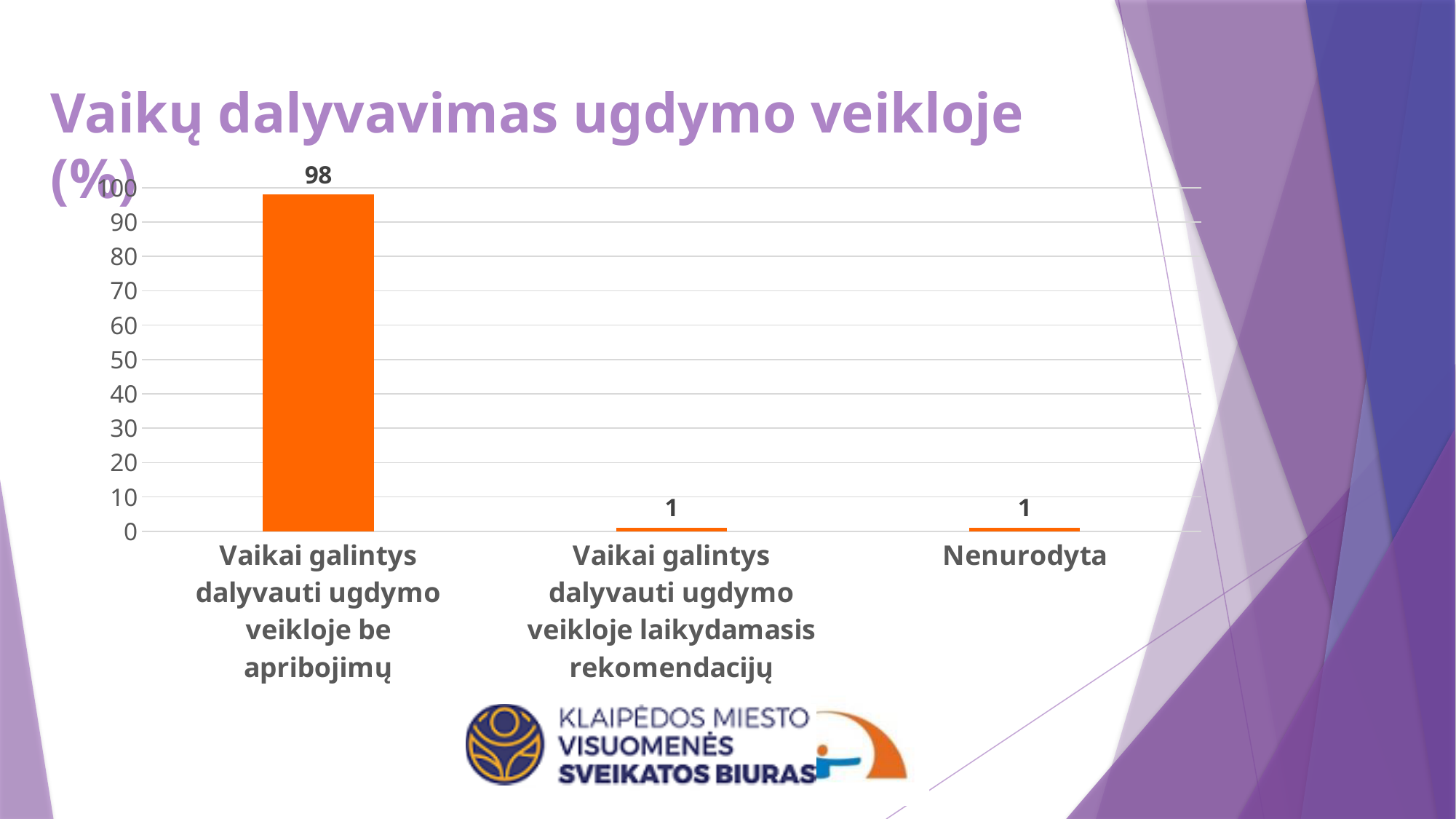
What is the title of the slide? Vaikų dalyvavimas ugdymo veikloje (%) What colour are the bars in the chart? orange What is the value for "Vaikai galintys dalyvauti ugdymo veikloje be apribojimų"? 98 Which category has the highest value? Vaikai galintys dalyvauti ugdymo veikloje be apribojimų Is the value for "Vaikai galintys dalyvauti ugdymo veikloje be apribojimų" greater or less than 90? greater What kind of chart is shown on the slide? bar chart Is the value for "Nenurodyta" greater or less than 10? less What is the value for "Vaikai galintys dalyvauti ugdymo veikloje laikydamasis rekomendacijų"? 1 Which is larger: the value for "Vaikai galintys dalyvauti ugdymo veikloje be apribojimų" or the value for "Vaikai galintys dalyvauti ugdymo veikloje laikydamasis rekomendacijų"? Vaikai galintys dalyvauti ugdymo veikloje be apribojimų What is the difference between the value for "Vaikai galintys dalyvauti ugdymo veikloje be apribojimų" and the value for "Nenurodyta"? 97 What is the value for "Nenurodyta"? 1 How many categories are shown on the x axis? 3